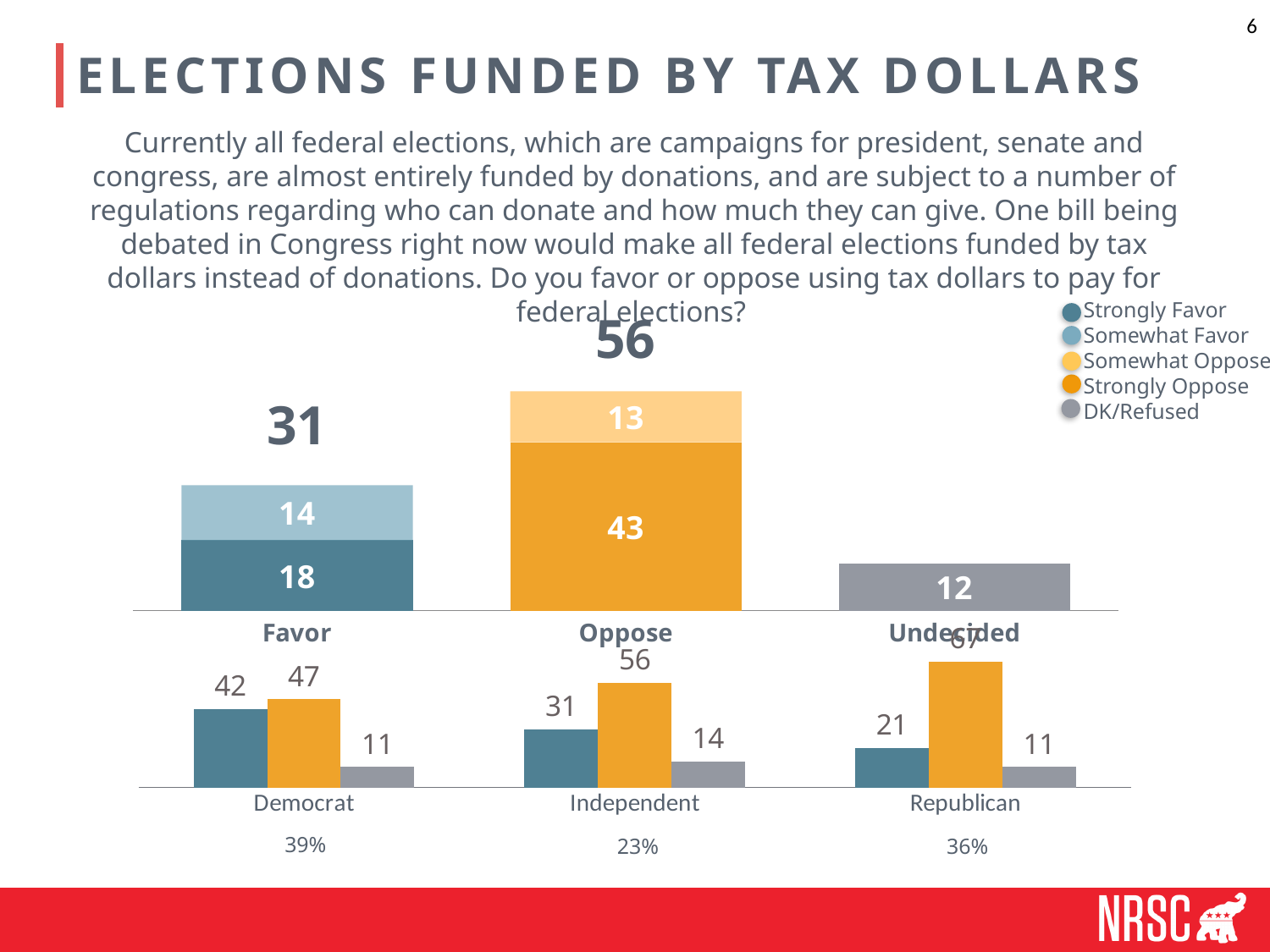
In the bottom chart by party, what is the value of the orange bar for Independent? 56 In the top stacked bar chart, which category has the lowest total? Undecided In the bottom chart by party, how many party categories are shown on the x axis? 3 In the top stacked bar chart, what is the total shown above the Oppose bar? 56 In the top stacked bar chart, what is the Strongly Oppose value in the Oppose bar? 43 In the top stacked bar chart, what is the difference between the Strongly Oppose value (43) and the Strongly Favor value (18)? 25 In the bottom chart by party, which party has the highest orange (oppose) bar? Republican In the top stacked bar chart, what is the Somewhat Favor value in the Favor bar? 14 What kind of chart is the bottom chart by party? Bar chart How many series does the legend of the top stacked bar chart list? 5 In the top stacked bar chart, what is the value for Undecided? 12 In the bottom chart by party, what is the value of the first (blue) bar for Democrat? 42